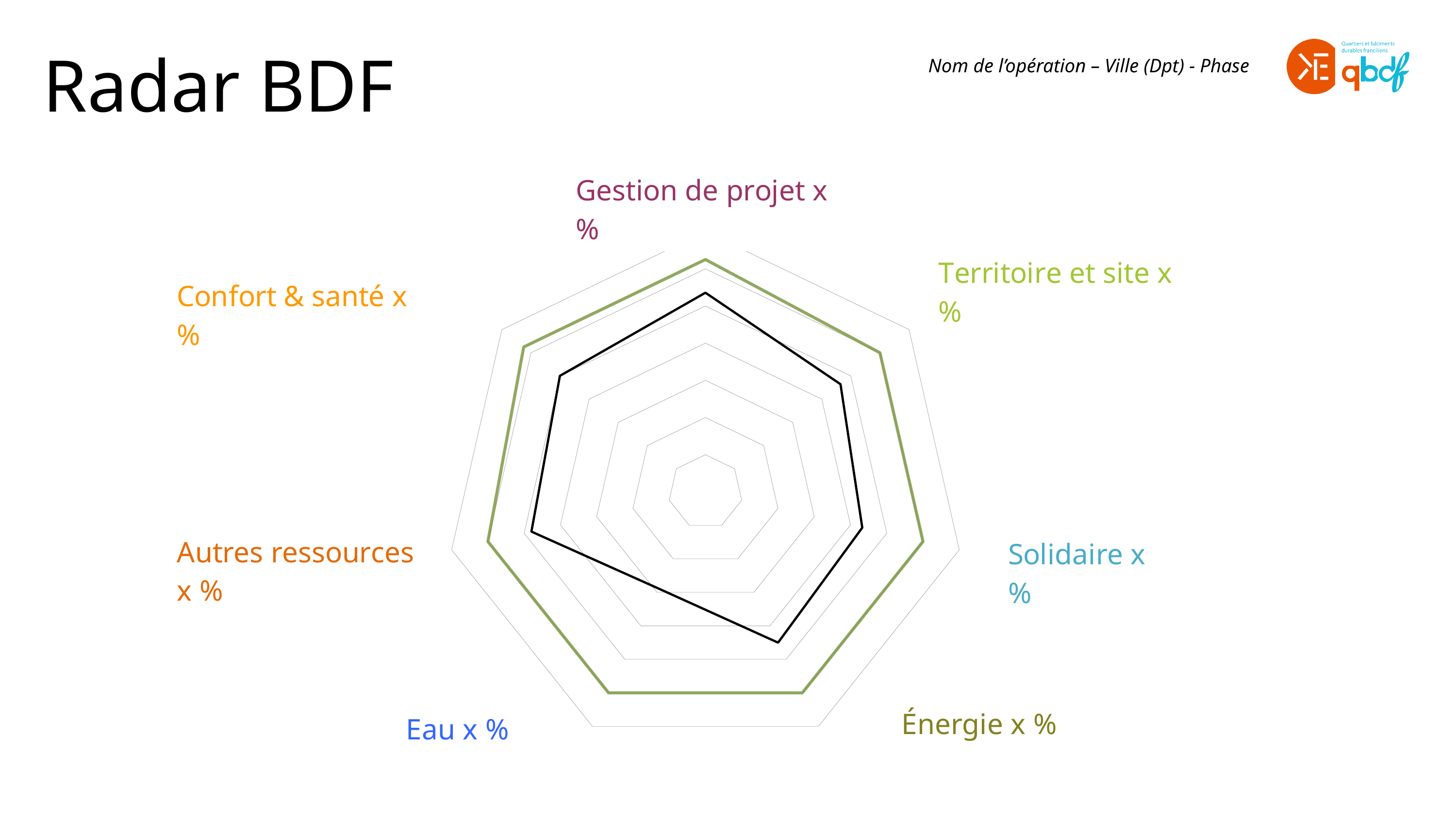
What is the title of the slide containing the radar chart? Radar BDF How many axes (categories) does the radar chart have? 7 Which axis label is shown at the bottom left of the radar chart? Eau x % On the Eau axis, which series has the larger value, the green line or the black line? The green line For the black series, is the value on the Gestion de projet axis larger or smaller than the value on the Eau axis? Larger Which axis label is shown at the top of the radar chart? Gestion de projet x % For the black series, which axis has the lowest value? Eau How many data series are plotted on the radar chart? 2 What kind of chart is shown on the slide? Radar chart On the Gestion de projet axis, which series has the larger value, the green line or the black line? The green line